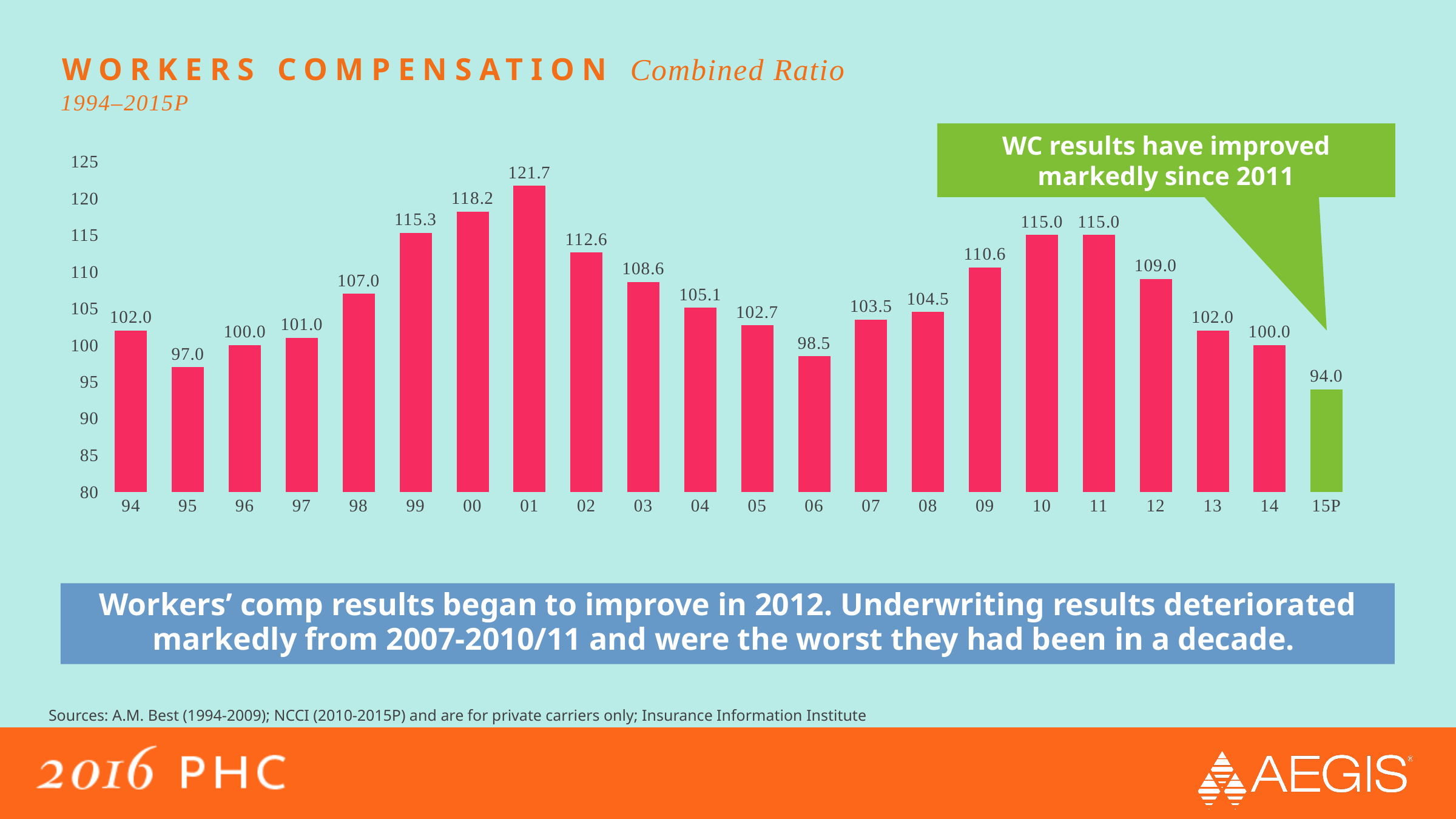
Which is larger, the combined ratio for 99 or for 02? 99 What is the combined ratio for 01? 121.7 What kind of chart is shown on the slide? Bar chart What colour is the bar for 15P? Green What is the difference between the combined ratio for 01 and for 15P? 27.7 What is the combined ratio for 15P? 94.0 Which year has the lowest combined ratio? 15P What is the combined ratio for 06? 98.5 How many years are shown on the x axis? 22 What is the difference between the combined ratio for 12 and for 13? 7.0 Do the combined ratio values rise or fall from 11 to 15P? Fall Which year has the highest combined ratio? 01